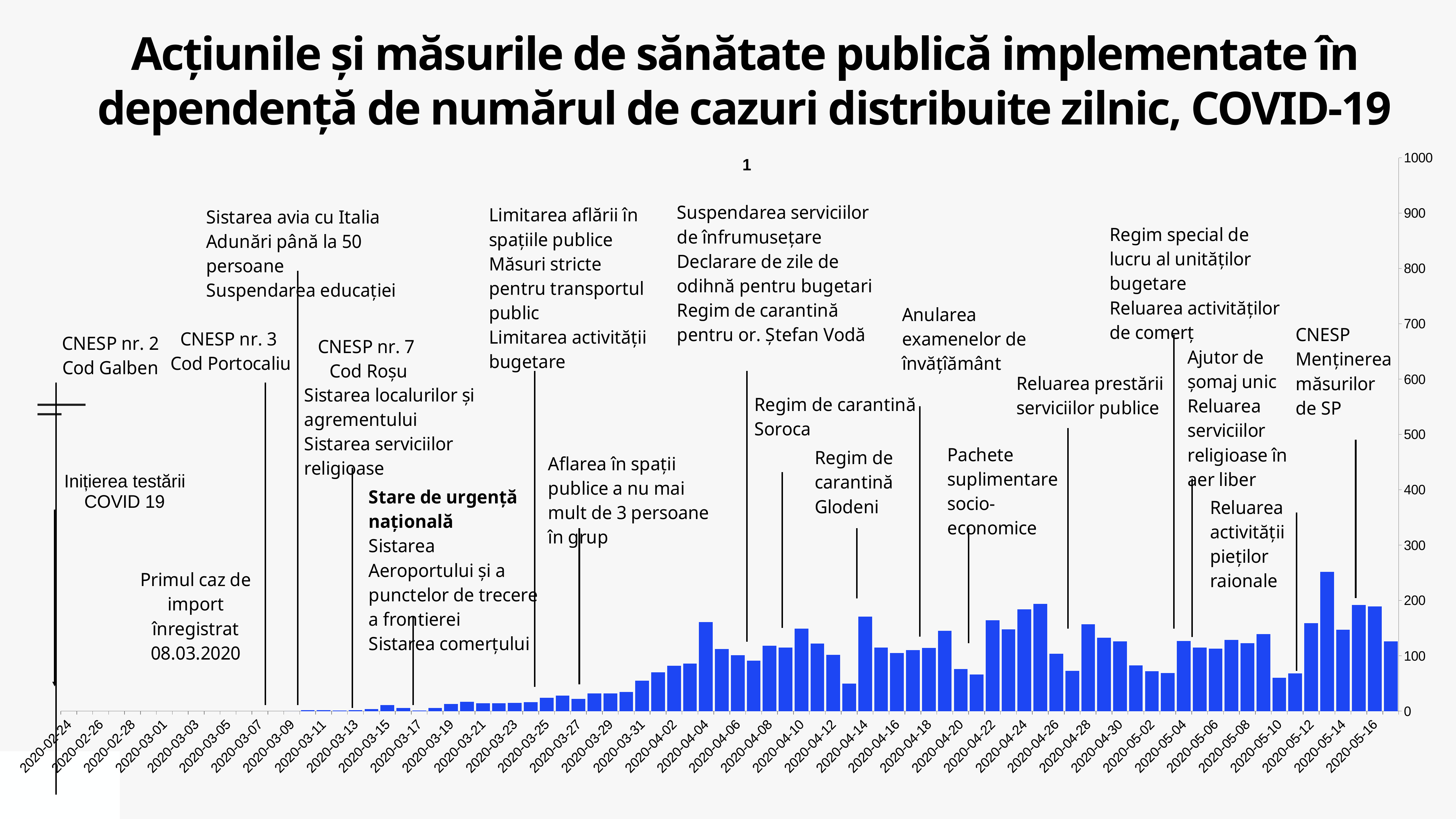
Which is larger, the value for 2020-04-24 or the value for 2020-04-20? 2020-04-24 Is the value for 2020-02-24 greater or less than 100? less Is the highest bar in the chart greater or less than 300? less What is the maximum value shown on the vertical axis of the chart? 1000 Is the value for 2020-03-07 greater or less than 100? less Overall, do the daily case values rise or fall from February to May along the x axis? rise What is the first date shown on the horizontal axis of the chart? 2020-02-24 Which is larger, the value for 2020-03-01 or the value for 2020-05-16? 2020-05-16 What kind of chart is shown on the slide? bar chart